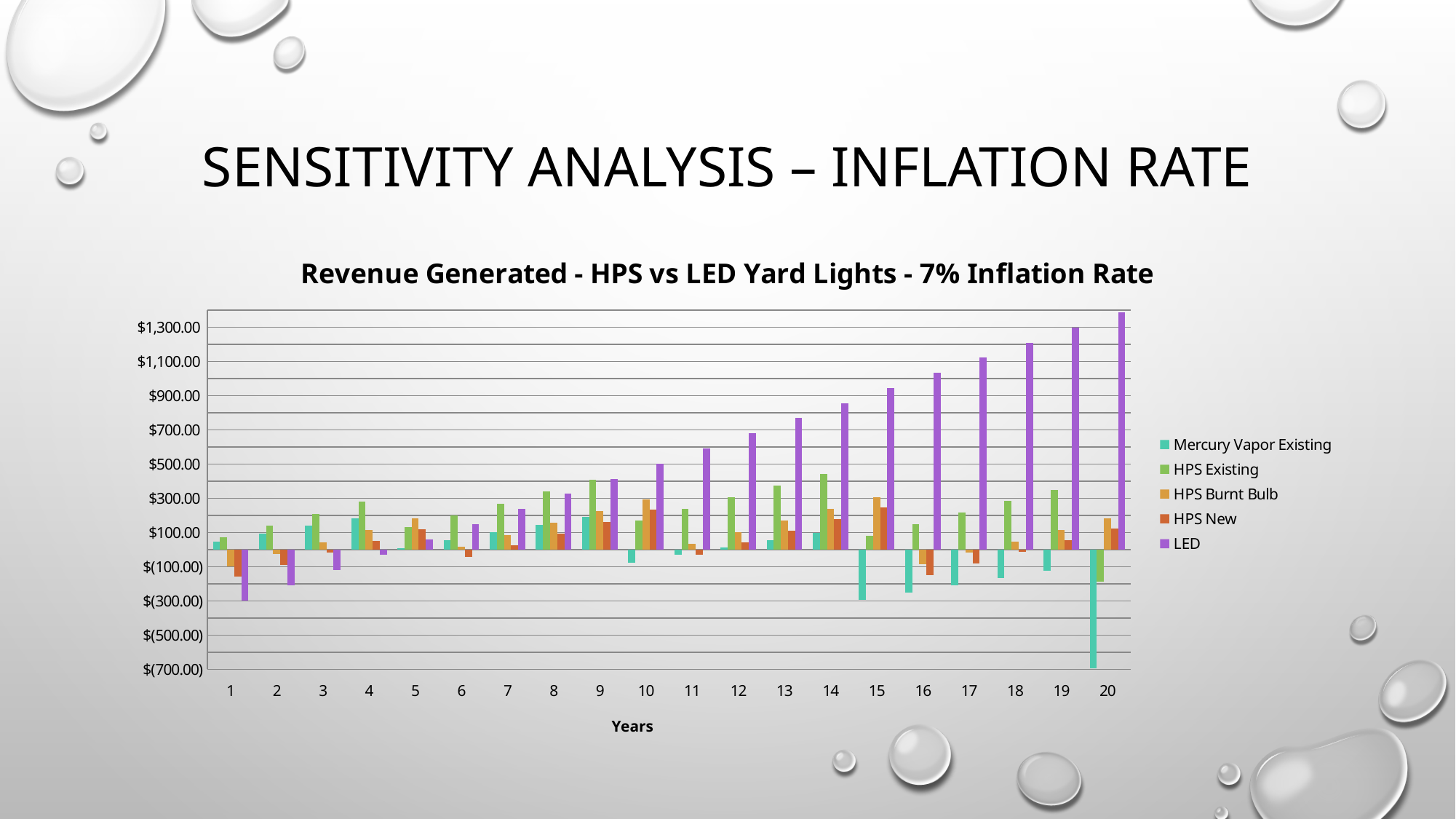
Is the LED value in year 20 greater or less than $1,300.00? greater What is the label of the x axis? Years What is the title of the chart? Revenue Generated - HPS vs LED Yard Lights - 7% Inflation Rate In which year does the LED series reach its highest value? 20 What type of chart is shown on the slide? bar chart Which series has the highest value in year 20? LED In year 20, which is larger: the LED value or the HPS Existing value? LED How many series does the legend list? 5 Does the LED series generally rise or fall from year 1 to year 20? rise Which series has the lowest value in year 20? Mercury Vapor Existing How many years are shown along the x axis? 20 Is the LED value in year 1 greater or less than $(100.00)? less